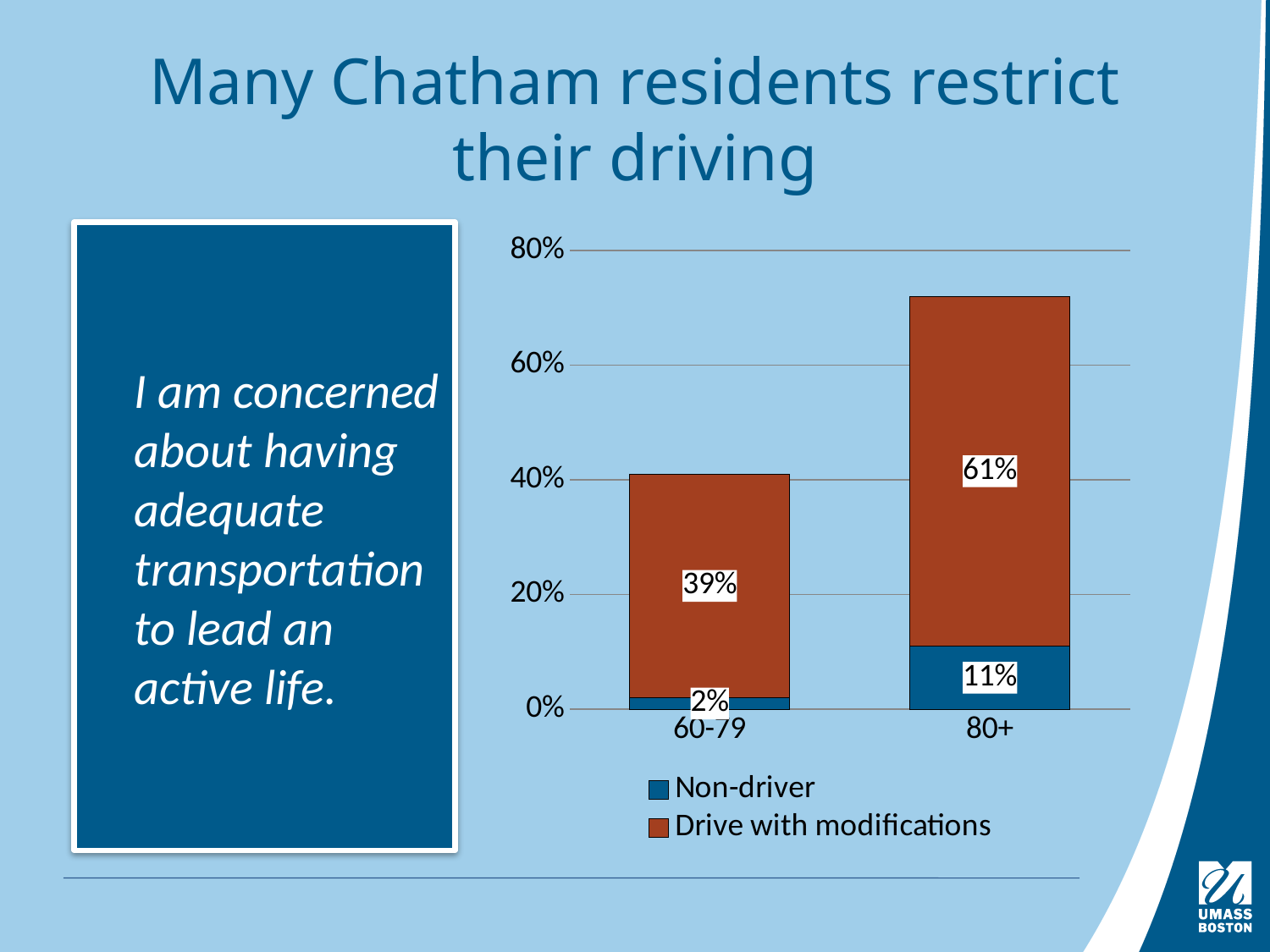
What is the value for Drive with modifications in the 60-79 age group? 39% What is the value for Non-driver in the 80+ age group? 11% What is the total of the stacked bar for the 60-79 age group? 41% Which age group has the higher value for Drive with modifications? 80+ What is the difference between the Drive with modifications values for 80+ and 60-79? 22% What is the value for Drive with modifications in the 80+ age group? 61% What is the total of the stacked bar for the 80+ age group? 72% What kind of chart is shown on the slide? Stacked bar chart Which age group has the lower value for Non-driver? 60-79 How many series does the legend list? 2 Is the Non-driver value larger for 60-79 or for 80+? 80+ What is the value for Non-driver in the 60-79 age group? 2%